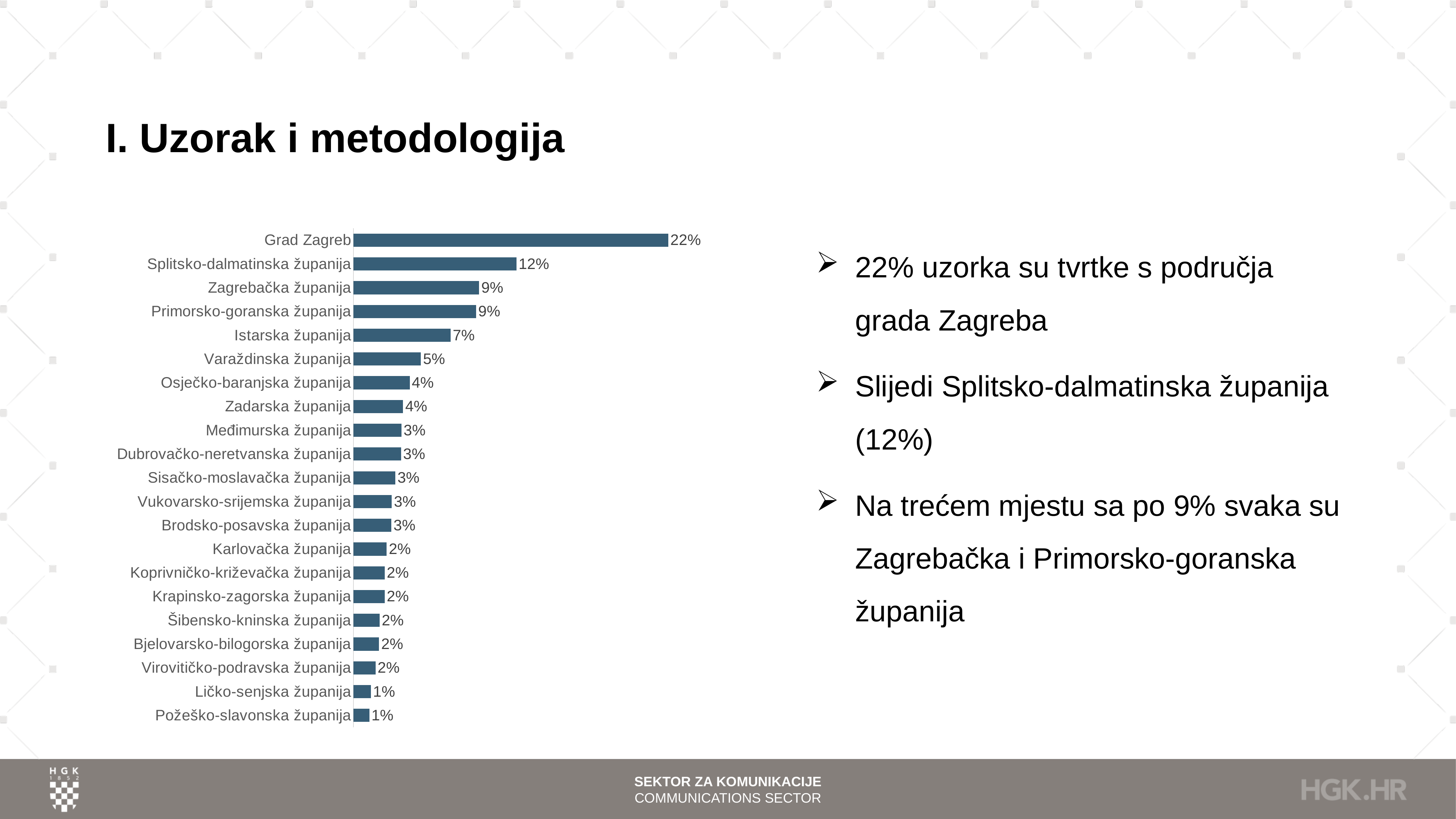
What is the value for Splitsko-dalmatinska županija? 12% Which category has the highest value? Grad Zagreb What is the value for Grad Zagreb? 22% What is the value for Varaždinska županija? 5% What kind of chart is shown on the slide? Bar chart What is the difference between the values for Grad Zagreb and Splitsko-dalmatinska županija? 10% What is the difference between the values for Zagrebačka županija and Istarska županija? 2% What is the value for Istarska županija? 7% Which is larger, the value for Istarska županija or the value for Varaždinska županija? Istarska županija How many categories are shown in the chart? 21 What is the value for Ličko-senjska županija? 1% How many categories have a value of 1%? 2